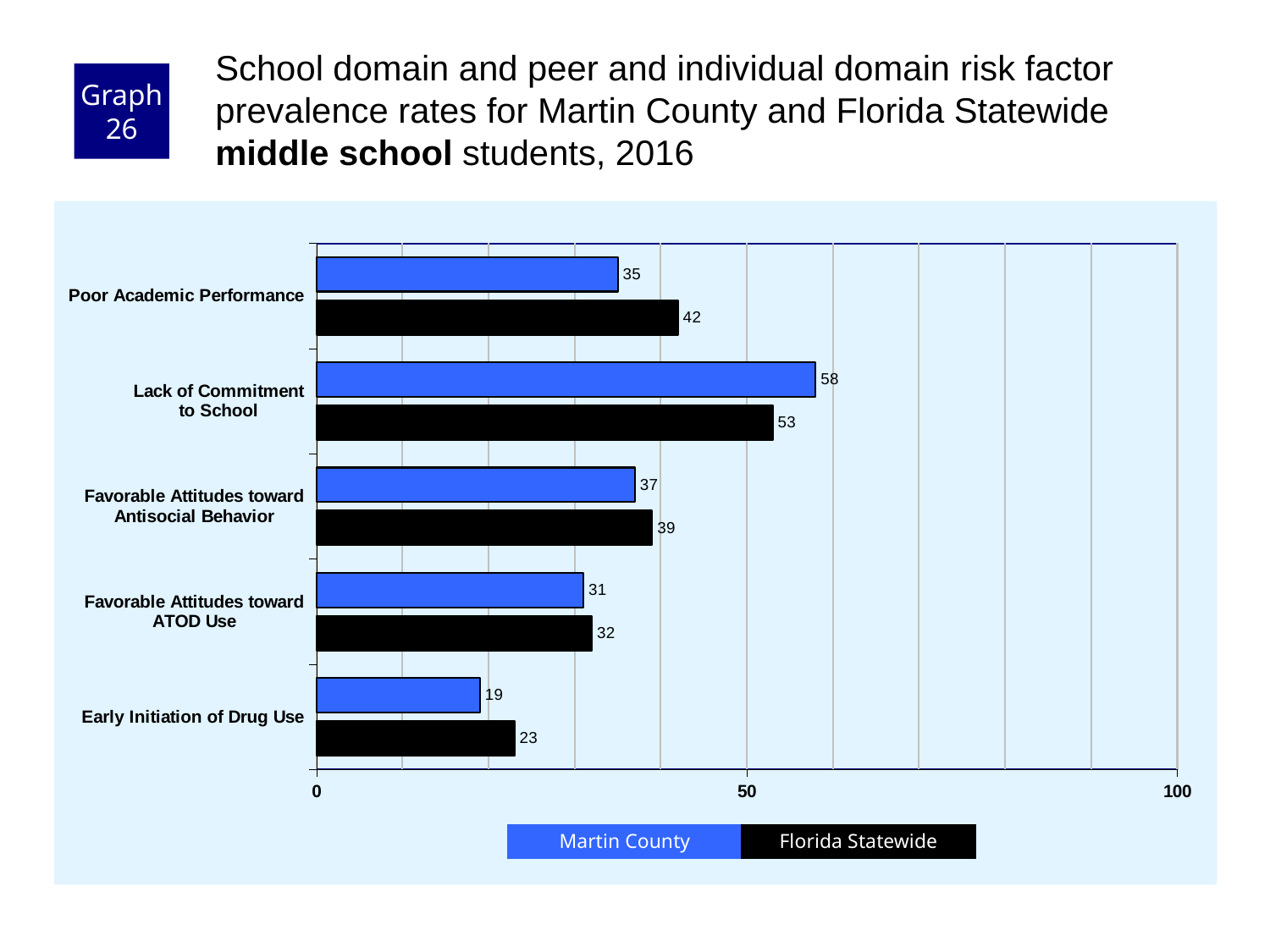
Which colour represents Florida Statewide in the chart? black How many series does the legend list? 2 For Lack of Commitment to School, which is larger: the Martin County value or the Florida Statewide value? Martin County Which risk factor has the lowest Florida Statewide value? Early Initiation of Drug Use What is the difference between the Florida Statewide and Martin County values for Poor Academic Performance? 7 What kind of chart is shown on the slide? bar chart What is the Florida Statewide value for Poor Academic Performance? 42 Which risk factor has the highest Martin County value? Lack of Commitment to School What is the Martin County value for Lack of Commitment to School? 58 Is the Martin County value for Early Initiation of Drug Use greater or less than 50? less How many risk factor categories are shown on the chart? 5 What is the Florida Statewide value for Early Initiation of Drug Use? 23